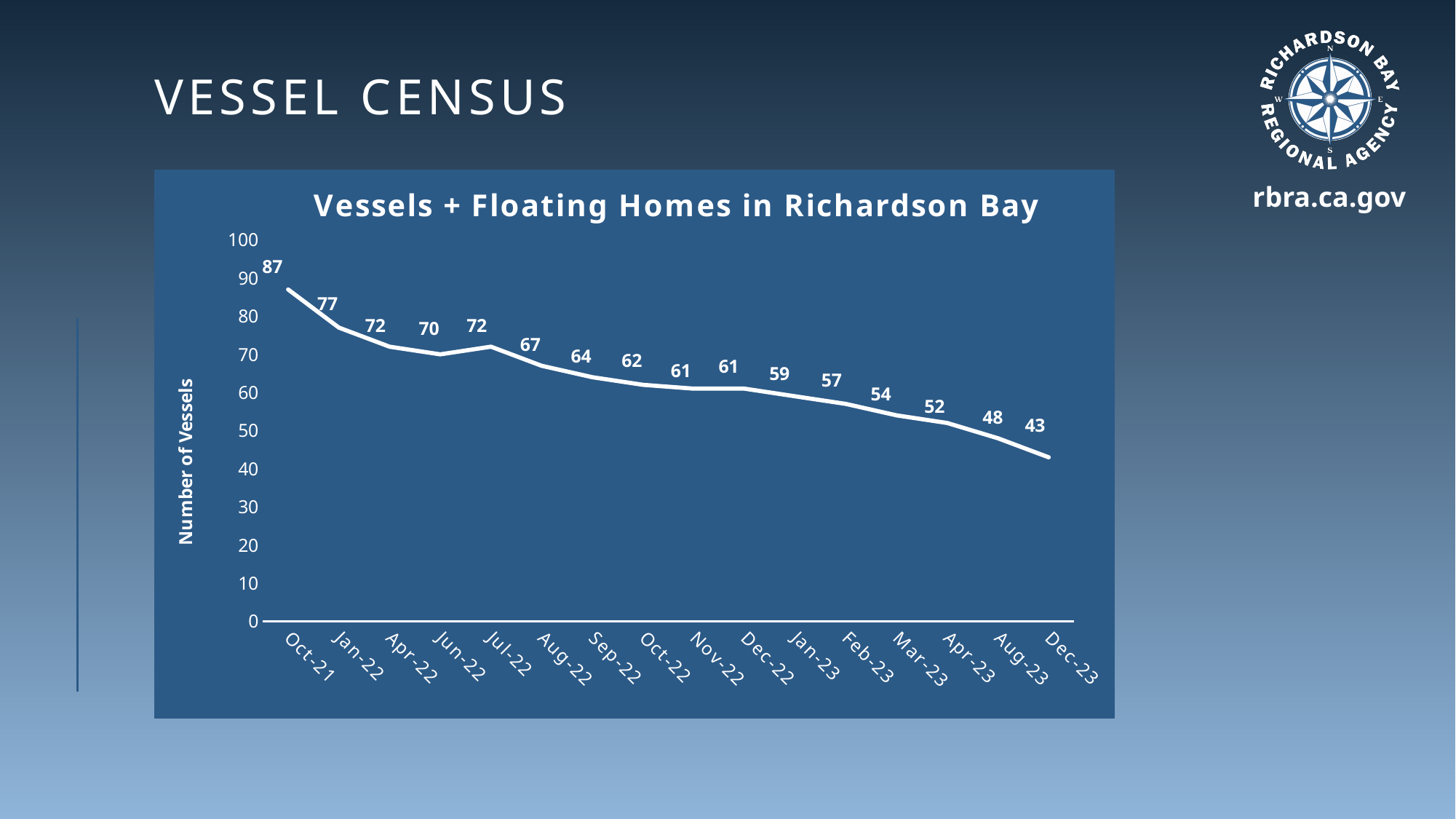
What is the difference between the values for Oct-21 and Dec-23? 44 Which month has the lowest number of vessels? Dec-23 What is the title of the chart? Vessels + Floating Homes in Richardson Bay What is the value for Jul-22? 72 Do the values generally rise or fall from Oct-21 to Dec-23? Fall How many data points are plotted on the chart? 16 What kind of chart is shown on the slide? Line chart What is the value for Feb-23? 57 What is the value for Oct-21? 87 Which is larger, the value for Jun-22 or the value for Jul-22? Jul-22 Which month has the highest number of vessels? Oct-21 What is the value for Dec-23? 43